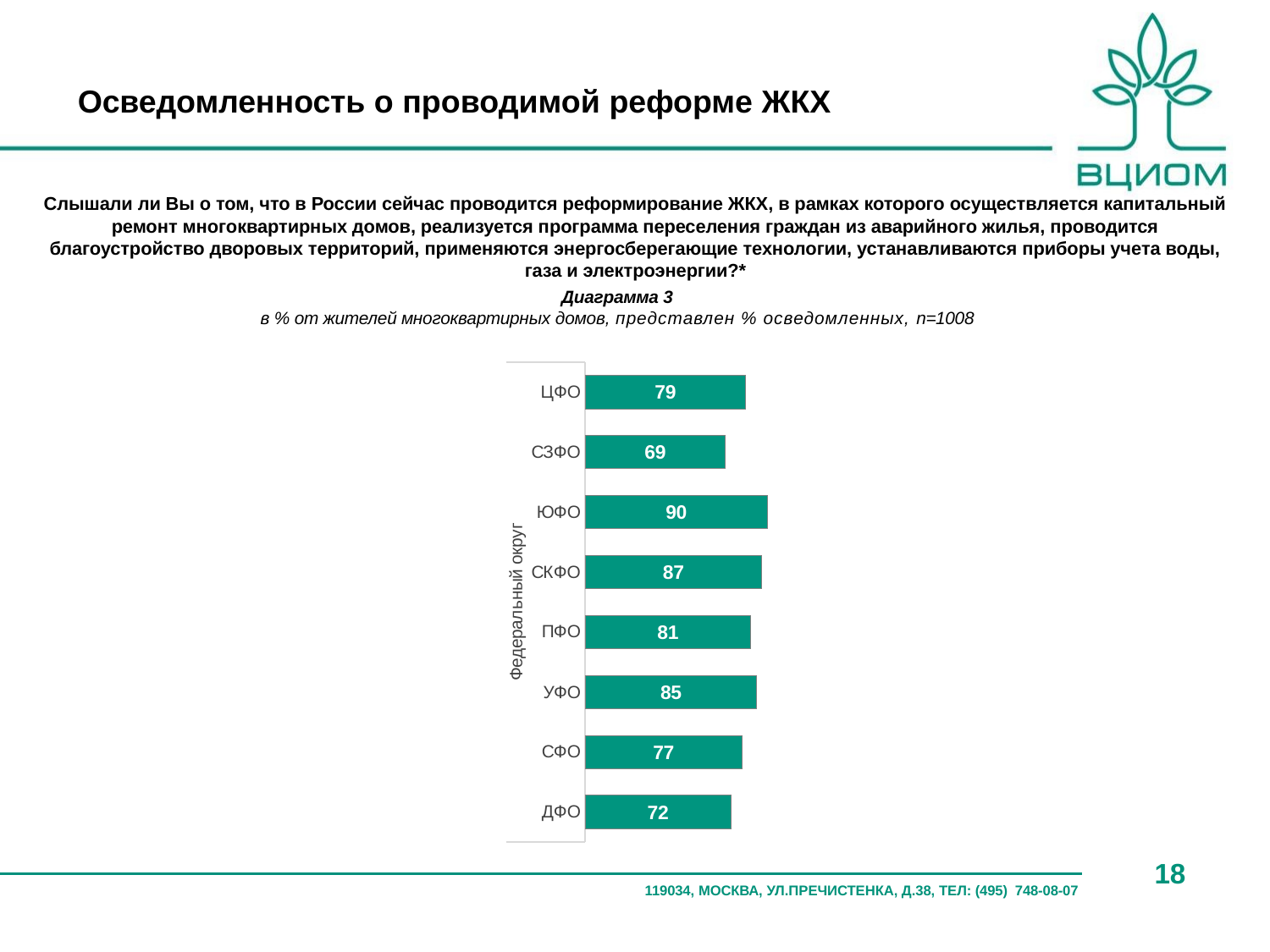
What is the label of the category axis of the chart? Федеральный округ Which federal district has the highest value? ЮФО What is the difference between the values for СКФО and ДФО? 15 What is the value for ПФО? 81 What kind of chart is shown on the slide? bar chart Which is larger, the value for СФО or the value for ДФО? СФО What is the value for СЗФО? 69 Which is larger, the value for УФО or the value for ЦФО? УФО What is the value for ЮФО? 90 How many federal districts are shown in the chart? 8 Which federal district has the lowest value? СЗФО What is the difference between the values for ЮФО and СЗФО? 21